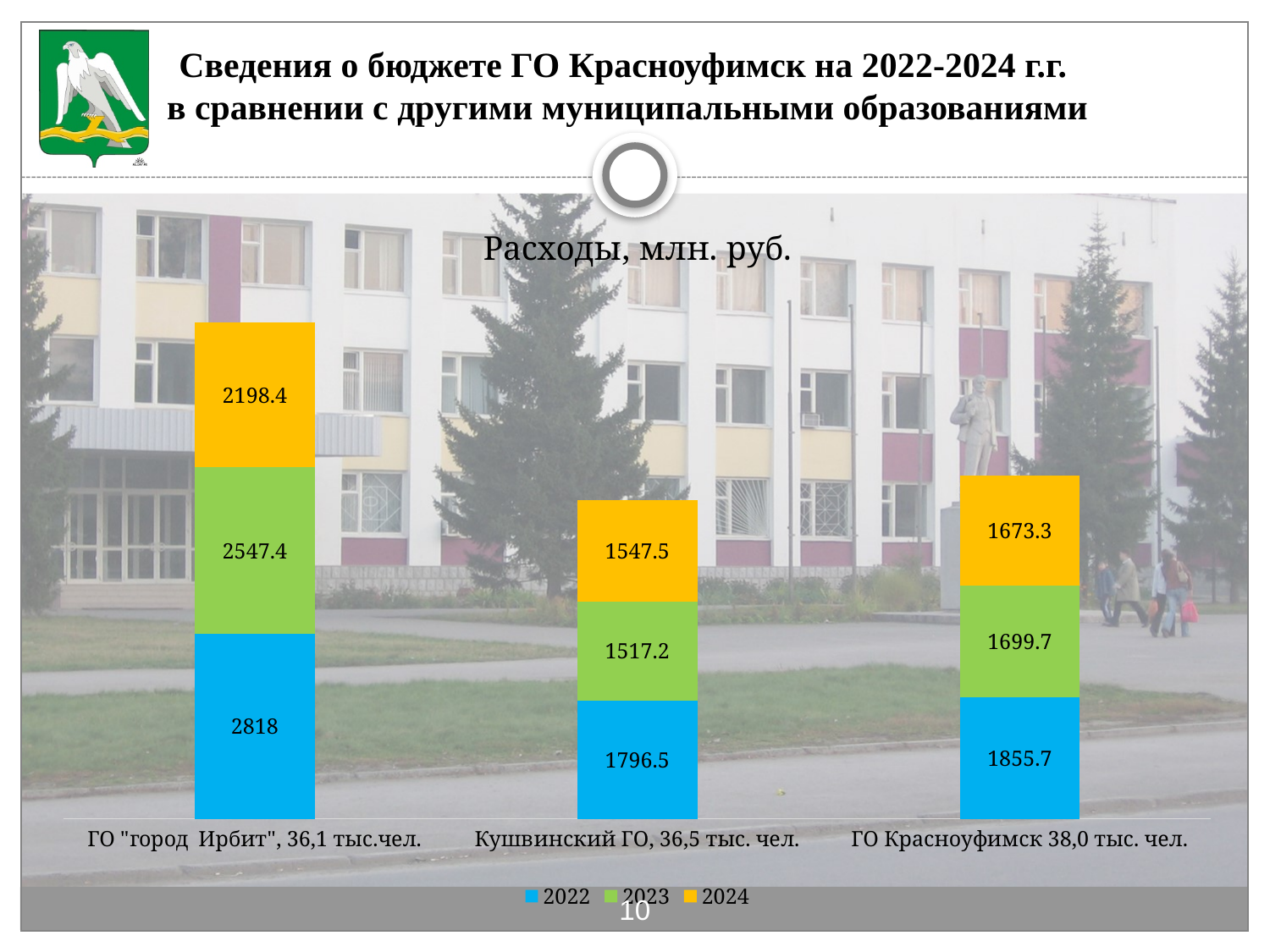
What is the 2023 value for ГО Красноуфимск? 1699.7 What is the total of the stacked bar for ГО Красноуфимск? 5228.7 What is the difference between the 2022 values for ГО Красноуфимск and Кушвинский ГО? 59.2 What is the 2024 value for Кушвинский ГО? 1547.5 What is the title of the chart? Расходы, млн. руб. What is the 2022 value for ГО "город Ирбит"? 2818 How many municipalities (categories) are shown on the x axis? 3 Which is larger: the 2024 value for ГО Красноуфимск or the 2024 value for Кушвинский ГО? ГО Красноуфимск Which municipality has the lowest 2023 value? Кушвинский ГО What type of chart is shown on the slide? Stacked bar chart How many series does the legend list? 3 Which municipality has the highest 2022 value? ГО "город Ирбит"